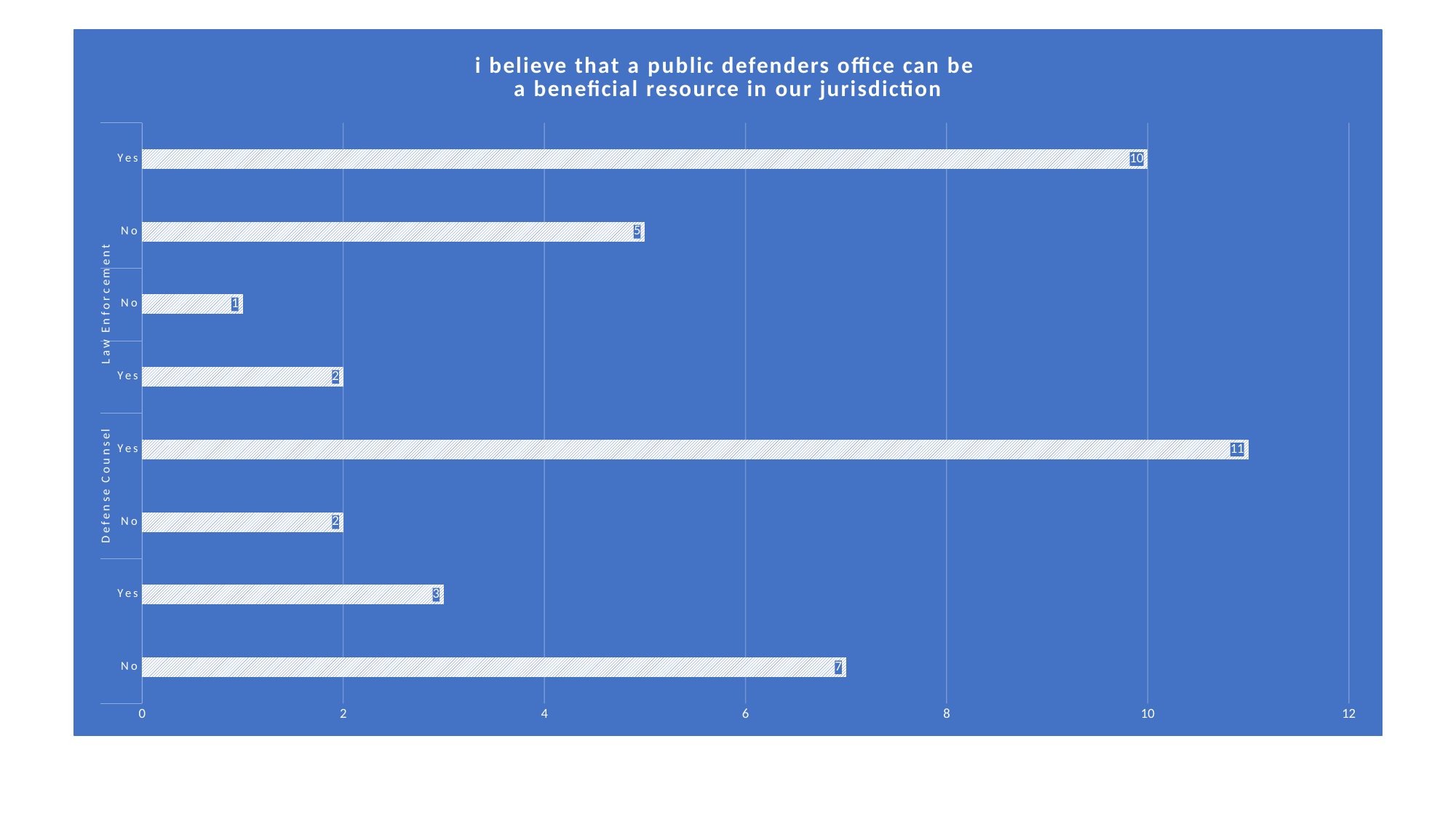
Which is larger: the topmost Yes bar or the bottom No bar? the topmost Yes bar How many bars are plotted in the chart? 8 What is the highest value shown by any bar in the chart? 11 What is the title of the chart? i believe that a public defenders office can be a beneficial resource in our jurisdiction What is the lowest value shown by any bar in the chart? 1 What is the difference between the Yes and No bars in the Defense Counsel group? 9 What is the value of the No bar in the Defense Counsel group? 2 What is the value of the No bar in the Law Enforcement group? 1 What kind of chart is shown on the slide? bar chart What is the value of the topmost bar (labelled Yes)? 10 What is the value of the Yes bar in the Defense Counsel group? 11 What is the value of the bottom bar (labelled No)? 7